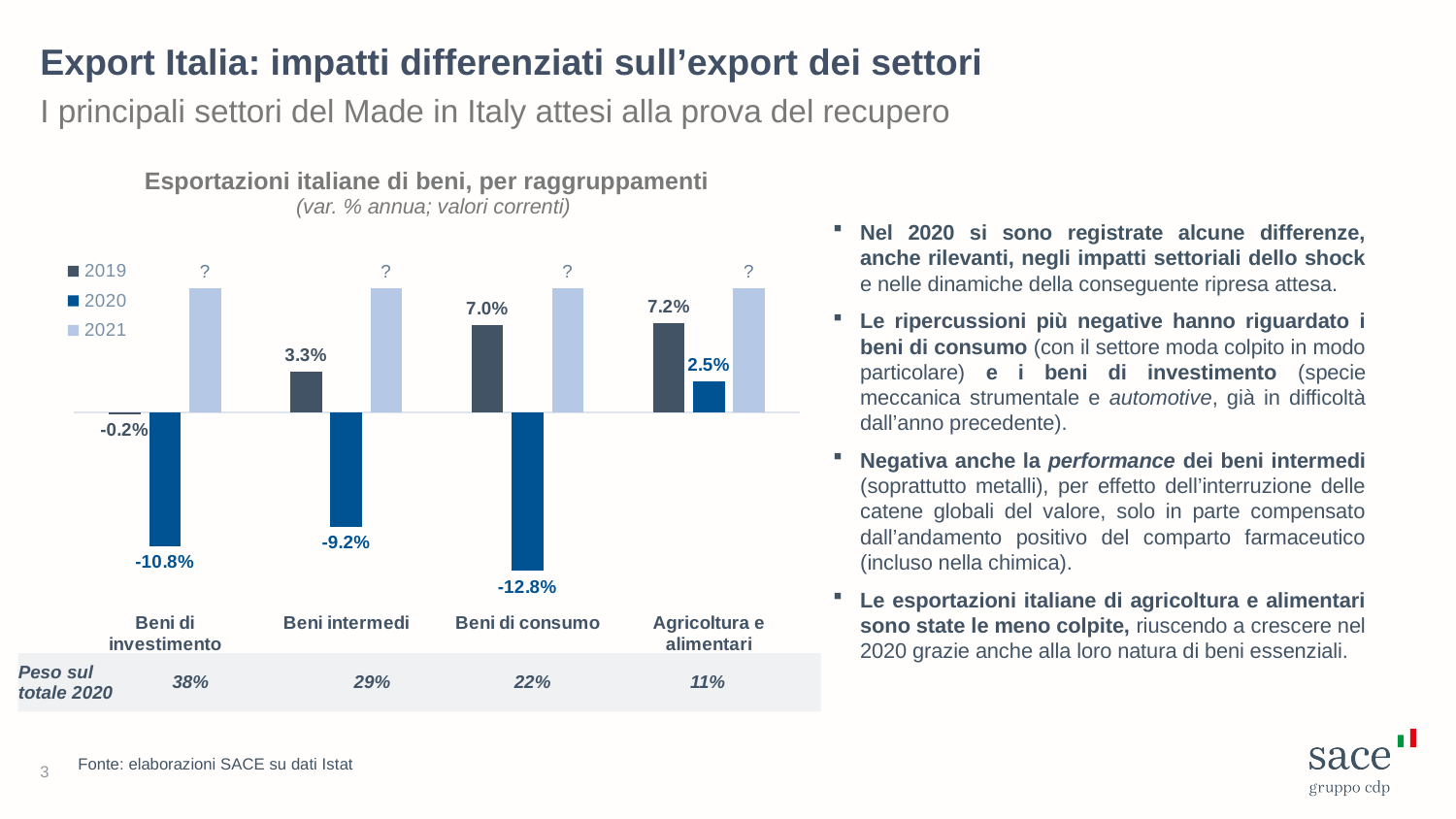
What is the 2020 value for Beni di consumo? -12.8% What is the 2020 value for Agricoltura e alimentari? 2.5% What kind of chart is shown on the slide? Bar chart Which category has the highest 2019 value? Agricoltura e alimentari How many categories are shown on the x axis? 4 What is the 2019 value for Beni intermedi? 3.3% What is the 2019 value for Beni di investimento? -0.2% Which category has the lowest 2020 value? Beni di consumo What is the difference between the 2019 and 2020 values for Beni di consumo? 19.8 percentage points What label is shown above the 2021 bars instead of a value? ? How many series does the legend list? 3 Which is larger, the 2020 value for Beni di investimento or the 2020 value for Beni intermedi? Beni intermedi